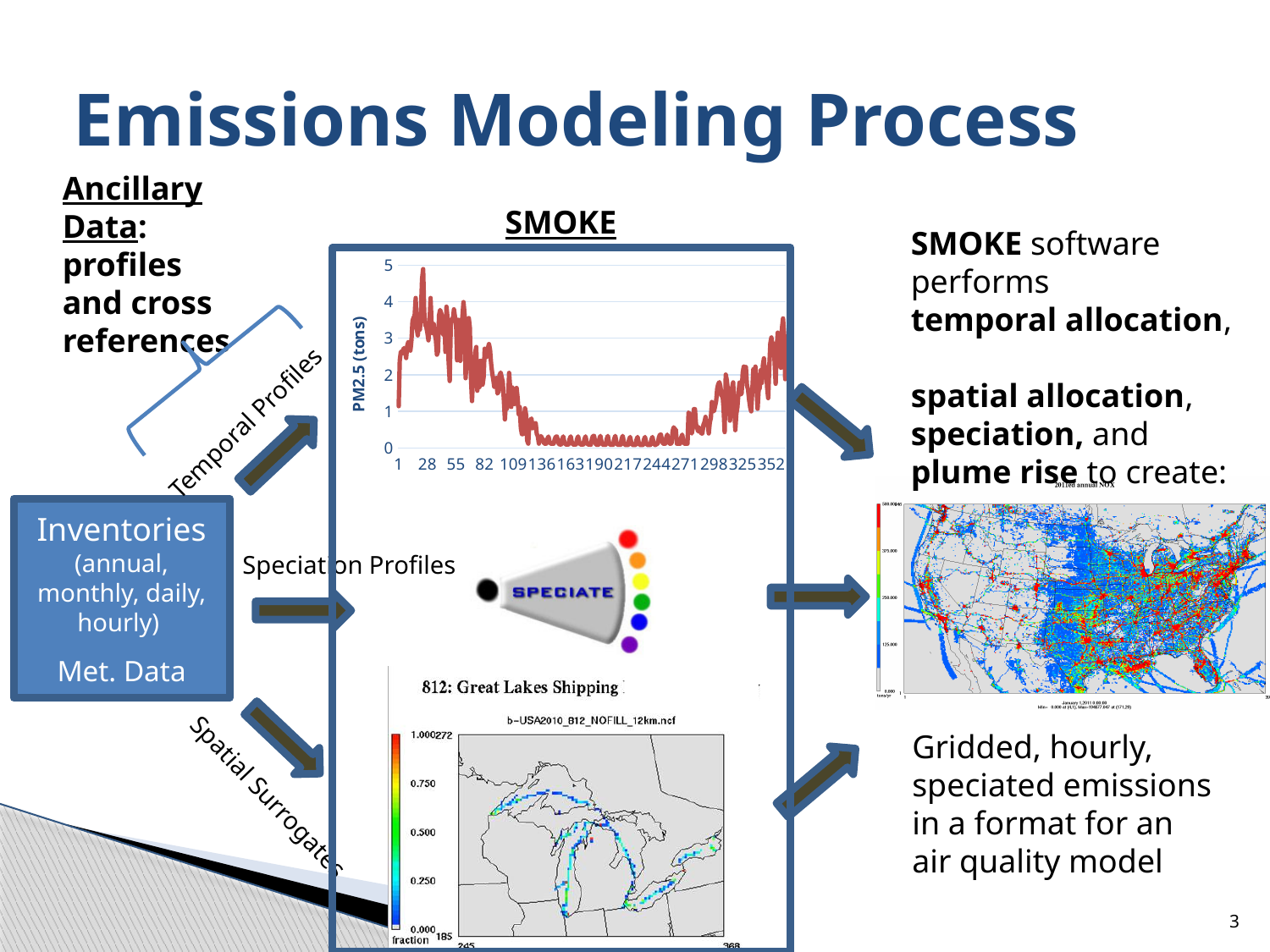
In the PM2.5 line chart, what is the label on the vertical axis? PM2.5 (tons) What kind of chart is shown inside the SMOKE box at the top of the slide? line chart In the PM2.5 line chart, is the value at x = 28 larger or smaller than the value at x = 190? larger In the PM2.5 line chart, is the value at x = 352 greater or less than 1? greater How many tick labels are printed along the horizontal axis of the PM2.5 line chart? 14 In the PM2.5 line chart, do the values generally rise or fall between x = 1 and x = 136? fall In the PM2.5 line chart, is the value at x = 244 greater or less than 2? less In the PM2.5 line chart, is the value at x = 190 greater or less than 1? less In the PM2.5 line chart, do the values generally rise or fall between x = 244 and x = 352? rise In the PM2.5 line chart, what is the highest value shown on the vertical axis? 5 How many data series are plotted in the PM2.5 line chart? 1